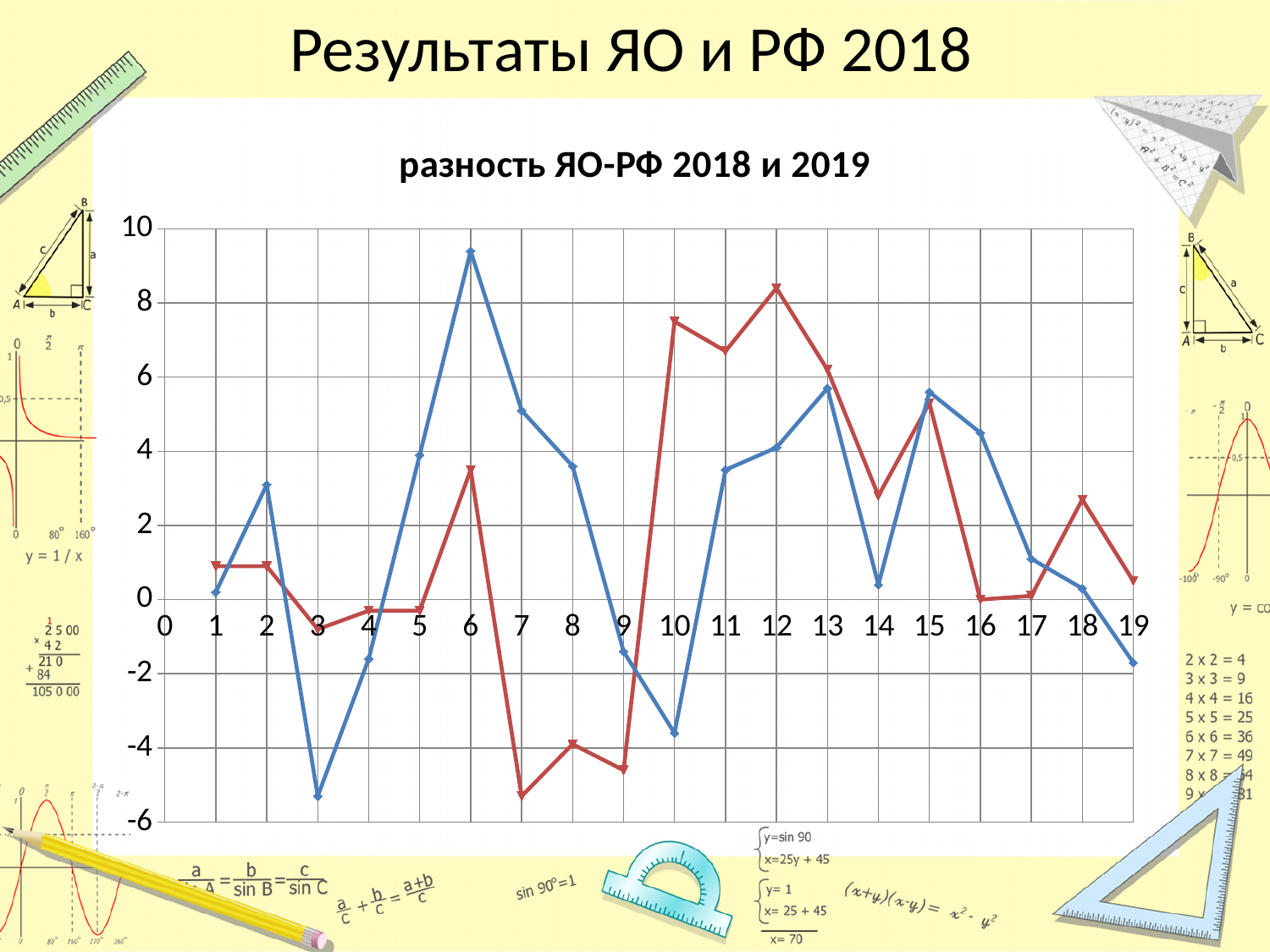
Is the value of the blue line at x = 3 greater or less than -4? less At which x-axis value does the red line reach its lowest point? 7 At which x-axis value does the red line reach its highest point? 12 At x = 10, which line has the higher value, the blue line or the red line? red line What is the title of the chart? разность ЯО-РФ 2018 и 2019 What kind of chart is shown on the slide? line chart At which x-axis value does the blue line reach its lowest point? 3 At which x-axis value does the blue line reach its highest point? 6 What colours are the two lines plotted on the chart? blue and red How many data points does the blue line have? 19 Is the value of the red line at x = 10 greater or less than 6? greater Is the value of the blue line at x = 6 greater or less than 8? greater